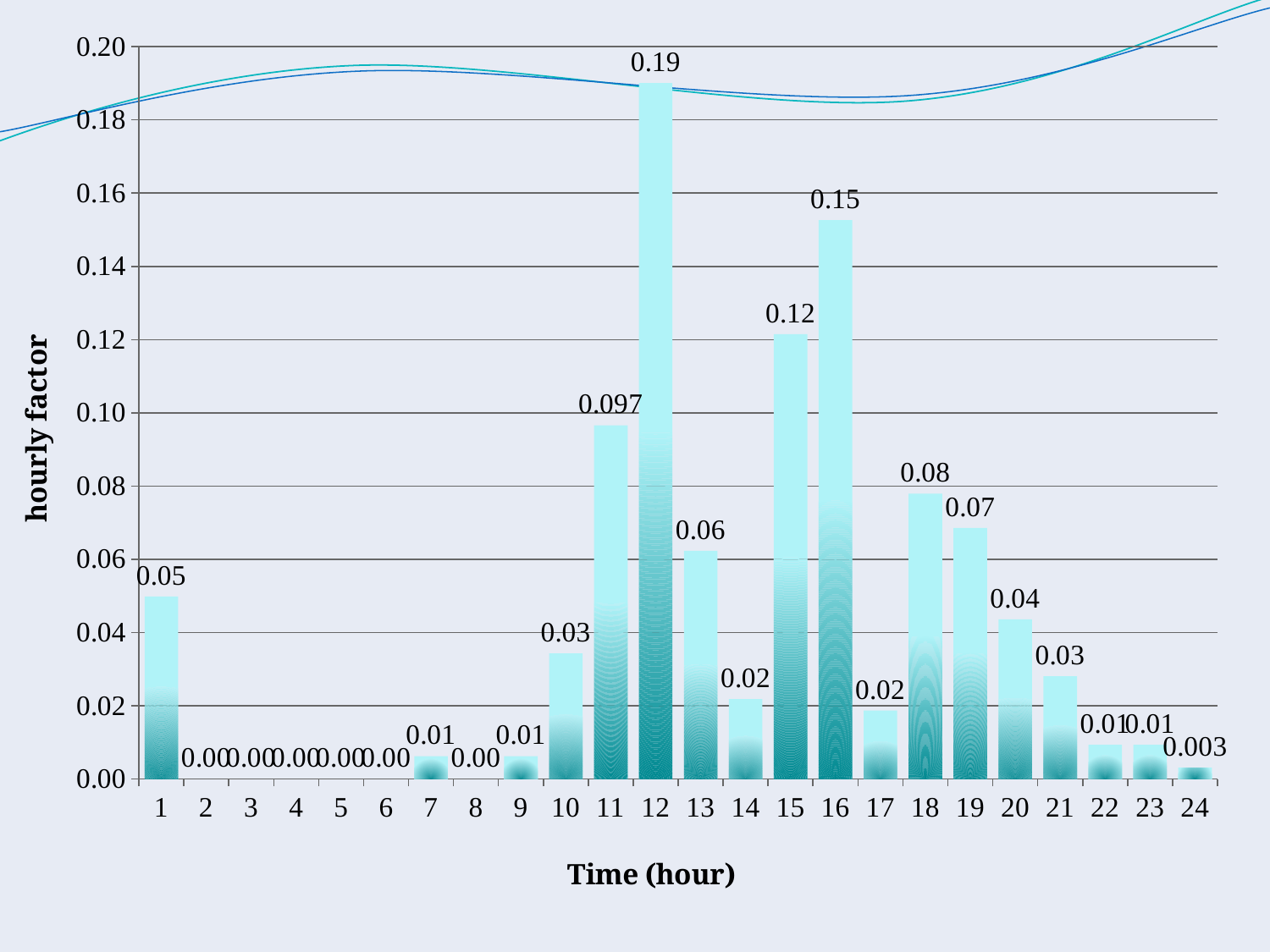
What is the hourly factor at hour 12? 0.19 What kind of chart is this? bar chart What is the difference between the hourly factor at hour 18 and at hour 19? 0.01 What is the difference between the hourly factor at hour 12 and at hour 16? 0.04 What is the label of the y axis? hourly factor How many hours are shown on the x axis? 24 Which is larger, the hourly factor at hour 15 or at hour 16? hour 16 What is the hourly factor at hour 11? 0.097 Is the hourly factor at hour 15 greater or less than 0.10? greater What is the hourly factor at hour 24? 0.003 Which hour has the highest hourly factor? 12 What is the hourly factor at hour 16? 0.15